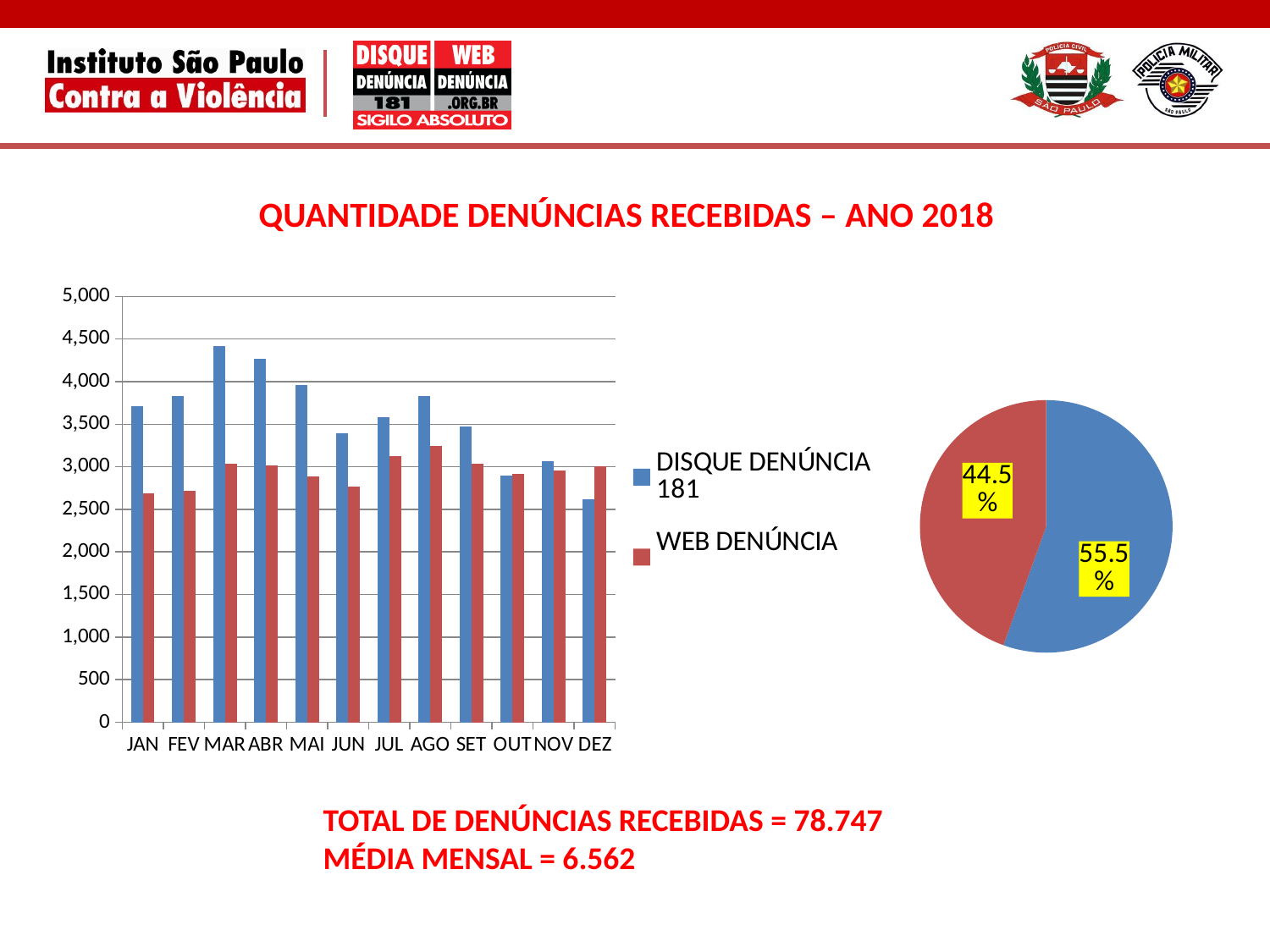
In the bar chart, how many months are shown on the x axis? 12 What type of chart is the chart on the left of the slide? bar chart In the bar chart, how many series does the legend list? 2 In the bar chart, which month has the lowest DISQUE DENÚNCIA 181 value? DEZ In the bar chart, which month has the highest DISQUE DENÚNCIA 181 value? MAR In the bar chart, is the WEB DENÚNCIA value for JUN greater or less than 3,000? less In the pie chart, what is the difference between the two slice percentages? 11% In the pie chart, what percentage is shown on the larger slice? 55.5% In the bar chart, which month has the highest WEB DENÚNCIA value? AGO In the bar chart, which series has the larger value in MAR, DISQUE DENÚNCIA 181 or WEB DENÚNCIA? DISQUE DENÚNCIA 181 What type of chart is the chart on the right of the slide? pie chart In the bar chart, is the DISQUE DENÚNCIA 181 value for MAR greater or less than 4,000? greater